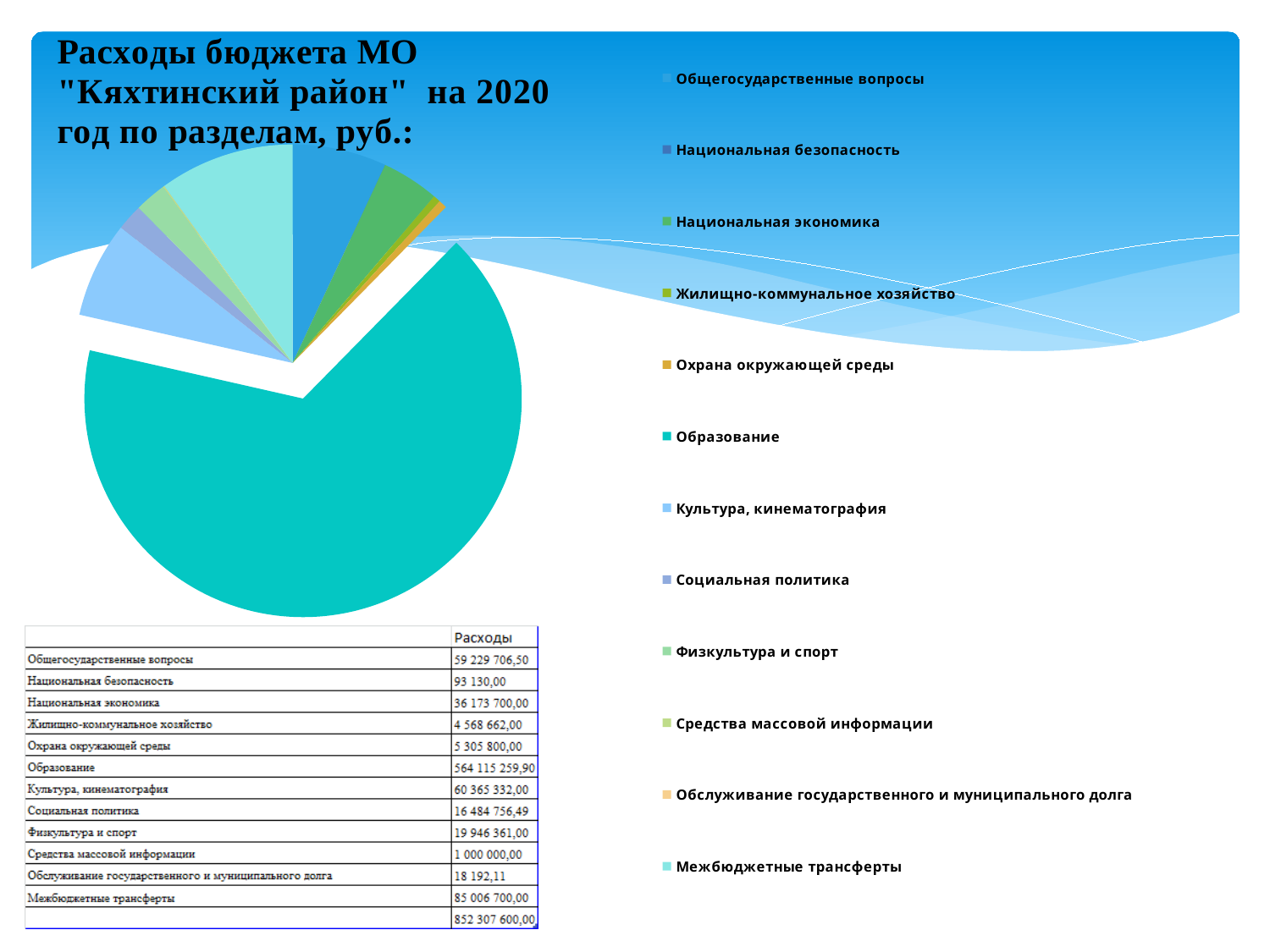
According to the table, what is the expenditure for Национальная безопасность? 93 130,00 Which budget section has the smallest expenditure? Обслуживание государственного и муниципального долга What is the difference between the expenditure for Культура, кинематография and Общегосударственные вопросы? 1 135 625,50 According to the table, what is the expenditure for Межбюджетные трансферты? 85 006 700,00 Which budget section has the largest expenditure? Образование What is the total expenditure shown at the bottom of the table? 852 307 600,00 How many budget sections (slices) does the pie chart show? 12 Which is larger: the expenditure for Межбюджетные трансферты or for Национальная экономика? Межбюджетные трансферты What is the title of the chart? Расходы бюджета МО "Кяхтинский район" на 2020 год по разделам, руб.: What kind of chart is shown on the slide? pie chart According to the table, what is the expenditure for Образование? 564 115 259,90